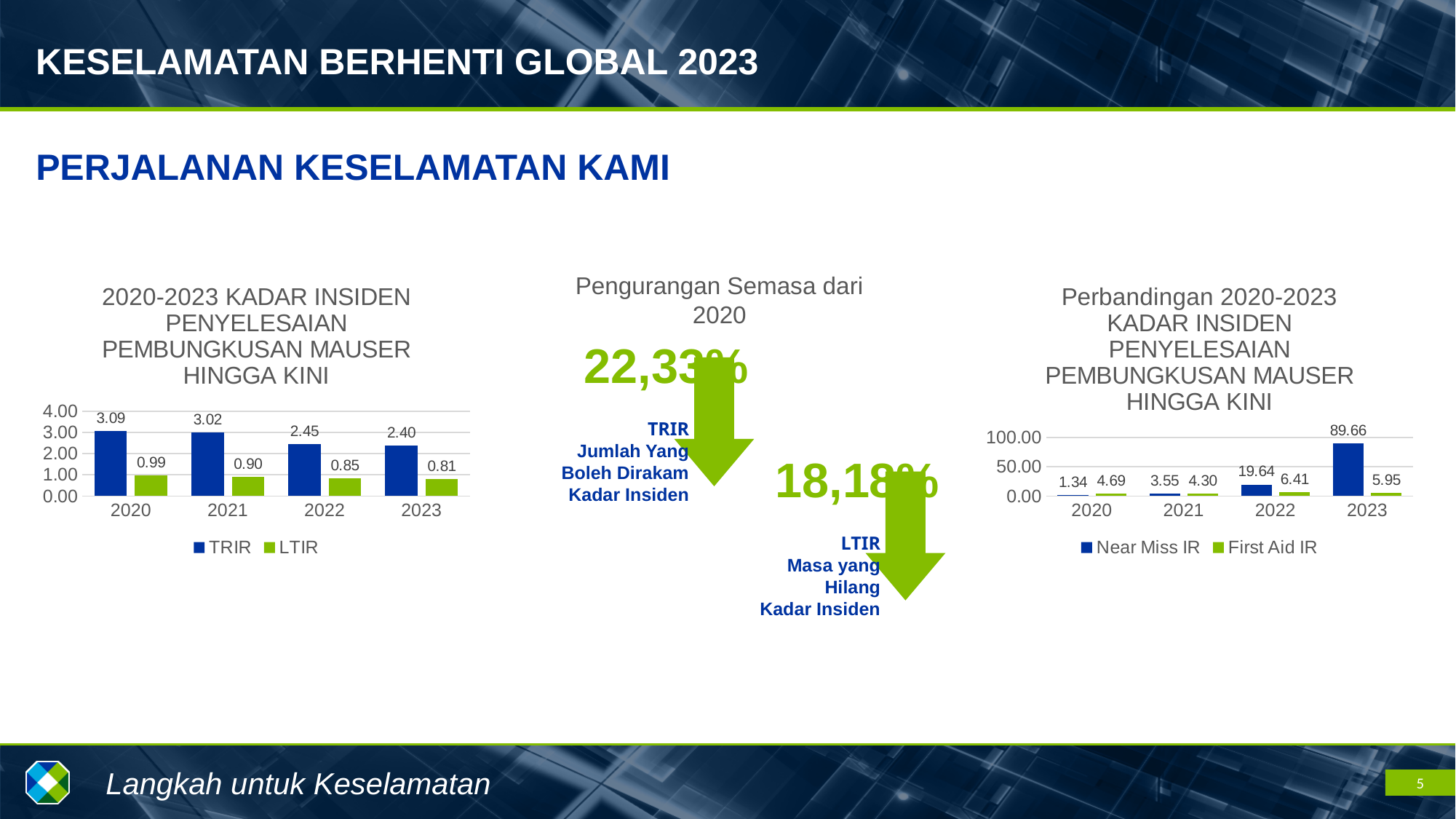
In the right chart, which is larger in 2020: Near Miss IR or First Aid IR? First Aid IR What type of chart is the left chart? bar chart In the left chart, what is the LTIR value for 2020? 0.99 How many series does the legend of the right chart list? 2 In the right chart, what is the First Aid IR value for 2022? 6.41 In the left chart, which year has the lowest LTIR value? 2023 In the left chart, which year has the highest TRIR value? 2020 In the left chart, what is the TRIR value for 2022? 2.45 In the right chart, what is the Near Miss IR value for 2023? 89.66 In the left chart, does the TRIR series rise or fall from 2020 to 2023? fall In the left chart, what is the difference between the TRIR values for 2020 and 2023? 0.69 In the right chart, which year has the highest Near Miss IR value? 2023